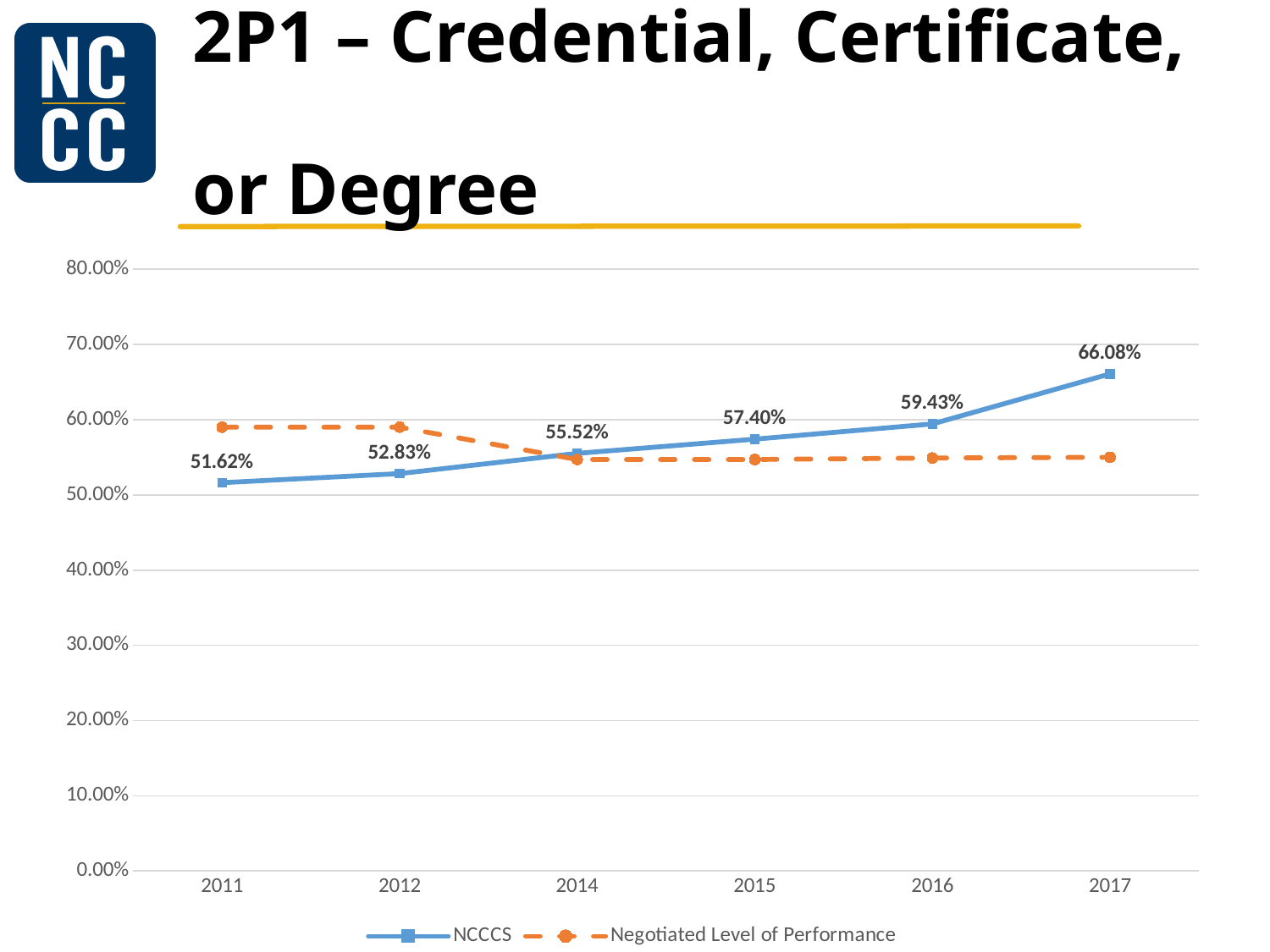
In 2017, which series has the higher value, NCCCS or Negotiated Level of Performance? NCCCS What is the difference between the NCCCS values for 2016 and 2015? 2.03 percentage points In 2011, which series has the higher value, NCCCS or Negotiated Level of Performance? Negotiated Level of Performance What is the NCCCS value for 2015? 57.40% How many series does the legend list? 2 What is the NCCCS value for 2011? 51.62% By how many percentage points did the NCCCS value increase from 2011 to 2017? 14.46 percentage points What is the NCCCS value for 2017? 66.08% Is the Negotiated Level of Performance value for 2011 greater or less than 50%? greater How many years are shown on the x axis? 6 In which year is the NCCCS value highest? 2017 In which year is the NCCCS value lowest? 2011